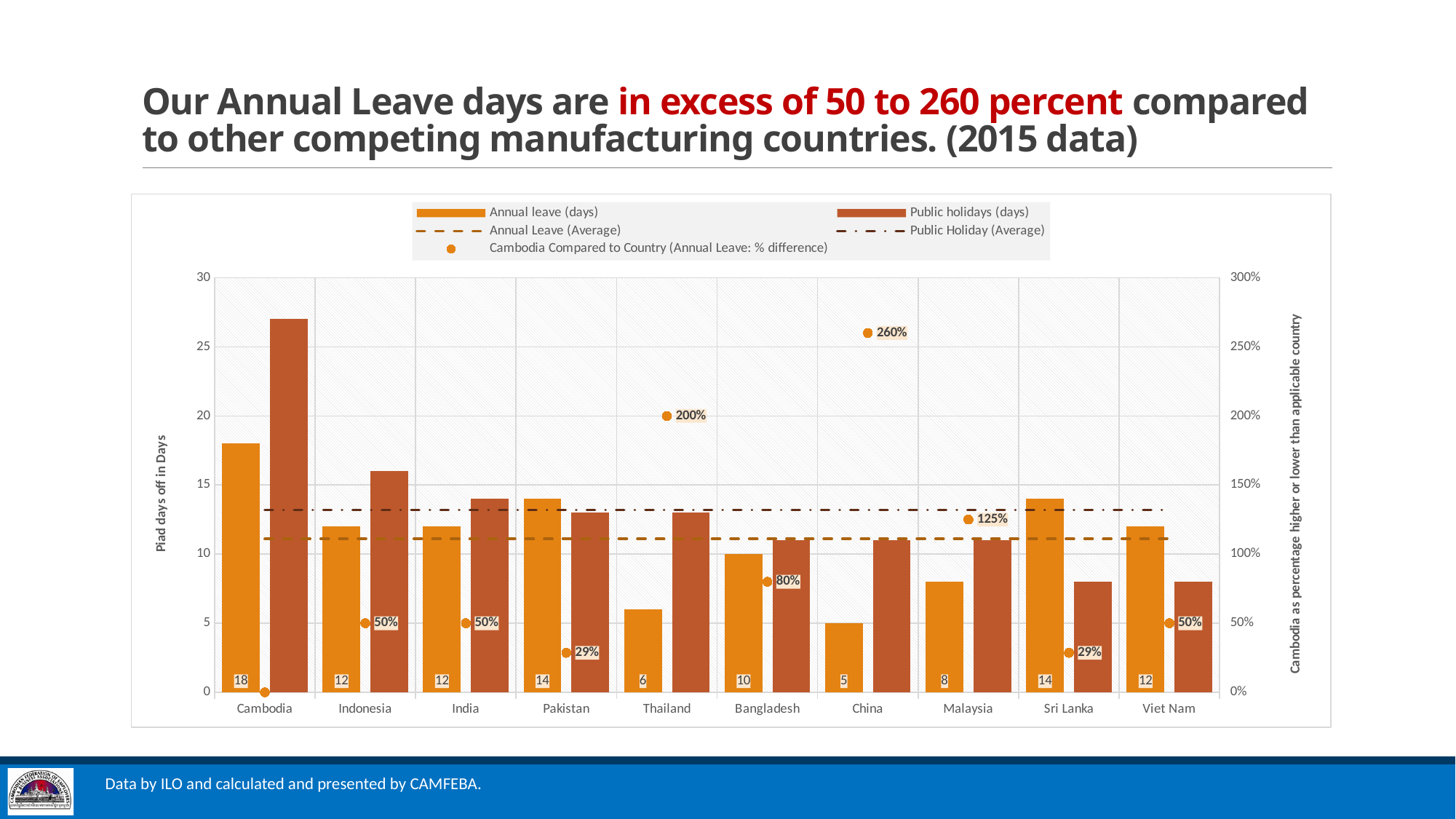
What is the 'Cambodia Compared to Country' percentage difference shown for China? 260% Which country has the tallest public holidays bar? Cambodia Which has more annual leave days, Pakistan or Bangladesh? Pakistan How many annual leave days does Thailand have? 6 Which country has the highest number of annual leave days? Cambodia Which country has the lowest number of annual leave days? China How many entries does the legend list? 5 What is the difference in annual leave days between Cambodia and China? 13 What is the 'Cambodia Compared to Country' percentage difference shown for Malaysia? 125% How many countries are shown on the x axis? 10 Is the public holidays value for Cambodia greater or less than 25? greater How many annual leave days does Cambodia have? 18